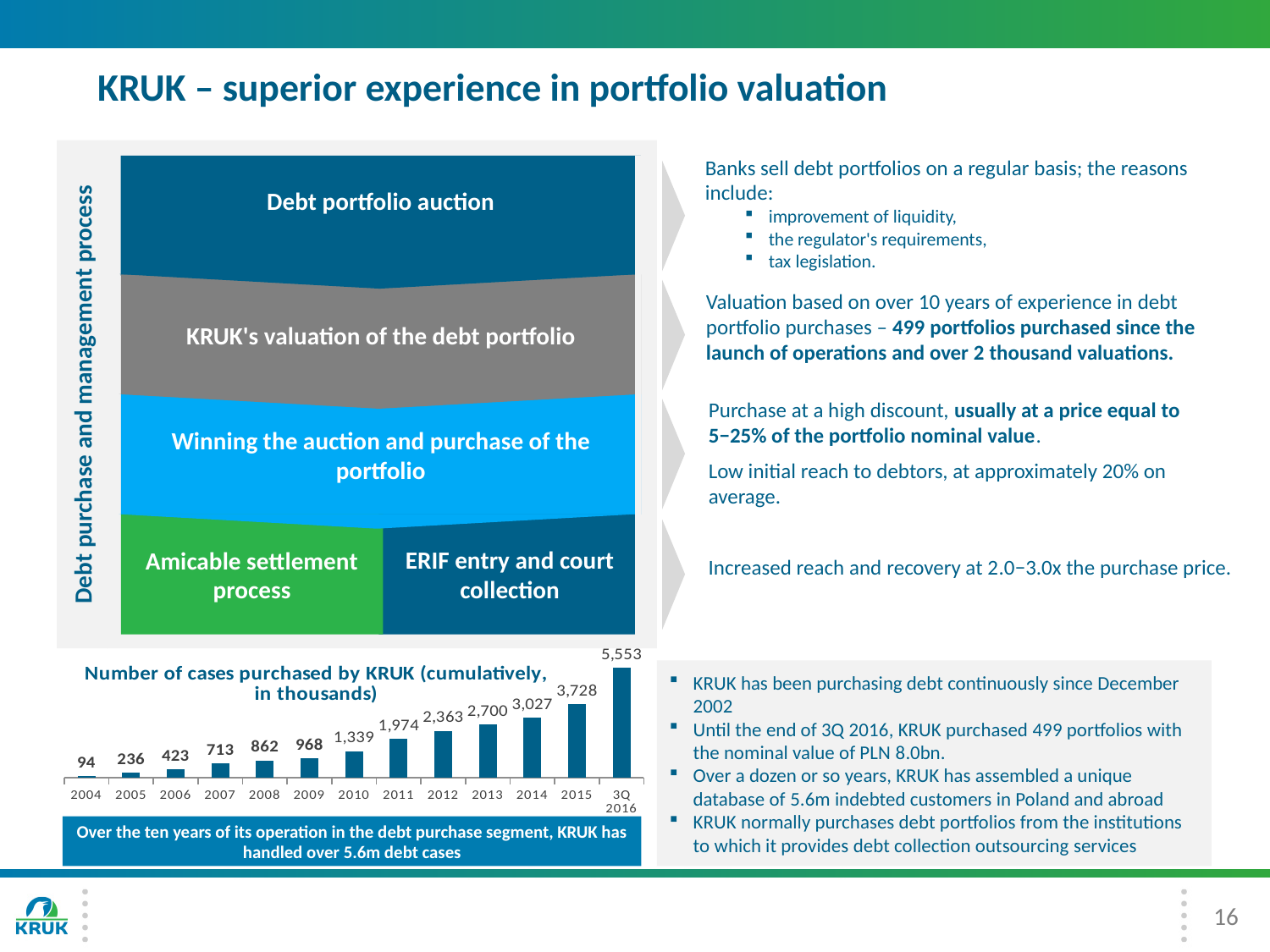
Which category has the highest value in the chart 'Number of cases purchased by KRUK (cumulatively, in thousands)'? 3Q 2016 What is the title of the bar chart on the slide? Number of cases purchased by KRUK (cumulatively, in thousands) In the chart 'Number of cases purchased by KRUK (cumulatively, in thousands)', which is larger, the value for 2008 or the value for 2009? 2009 What kind of chart is 'Number of cases purchased by KRUK (cumulatively, in thousands)'? Bar chart Which category has the lowest value in the chart 'Number of cases purchased by KRUK (cumulatively, in thousands)'? 2004 What is the value for 3Q 2016 in the chart 'Number of cases purchased by KRUK (cumulatively, in thousands)'? 5,553 What is the value for 2004 in the chart 'Number of cases purchased by KRUK (cumulatively, in thousands)'? 94 What is the value for 2010 in the chart 'Number of cases purchased by KRUK (cumulatively, in thousands)'? 1,339 Do the values in the chart 'Number of cases purchased by KRUK (cumulatively, in thousands)' rise or fall from 2004 to 3Q 2016? Rise What is the difference between the values for 2015 and 2014 in the chart 'Number of cases purchased by KRUK (cumulatively, in thousands)'? 701 What is the difference between the values for 3Q 2016 and 2015 in the chart 'Number of cases purchased by KRUK (cumulatively, in thousands)'? 1,825 How many categories are shown on the x axis of the chart 'Number of cases purchased by KRUK (cumulatively, in thousands)'? 13